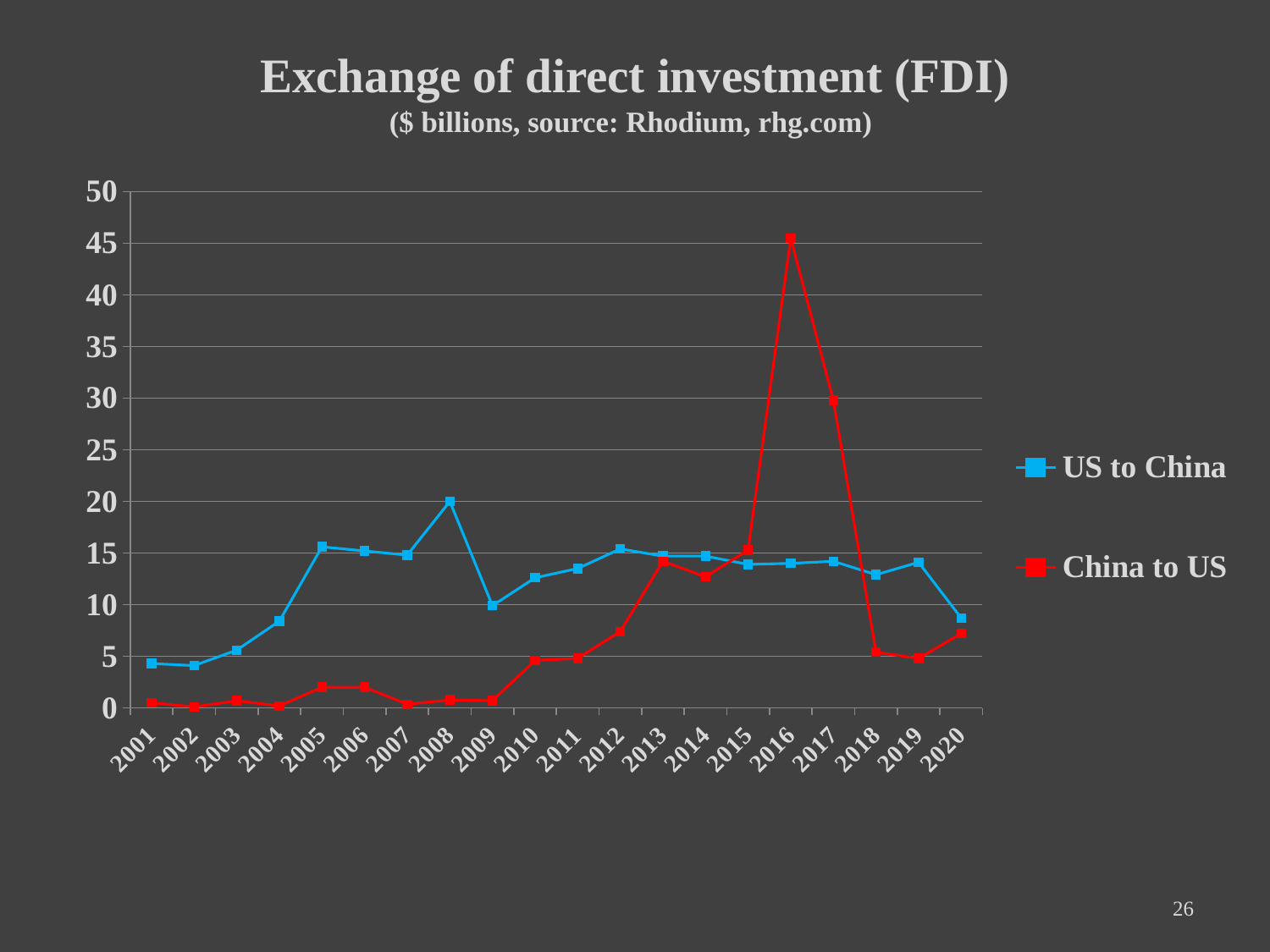
Is the China to US value for 2017 greater or less than 25? greater Is the China to US value for 2001 greater or less than 5? less Does the China to US series rise or fall from 2016 to 2018? fall What kind of chart is shown on the slide? line chart How many series does the legend list? 2 Is the US to China value for 2008 greater or less than 15? greater In 2016, which series has the larger value, US to China or China to US? China to US In 2005, which series has the larger value, US to China or China to US? US to China How many years are plotted along the x axis? 20 In which year does the US to China series reach its highest value? 2008 In which year does the China to US series reach its highest value? 2016